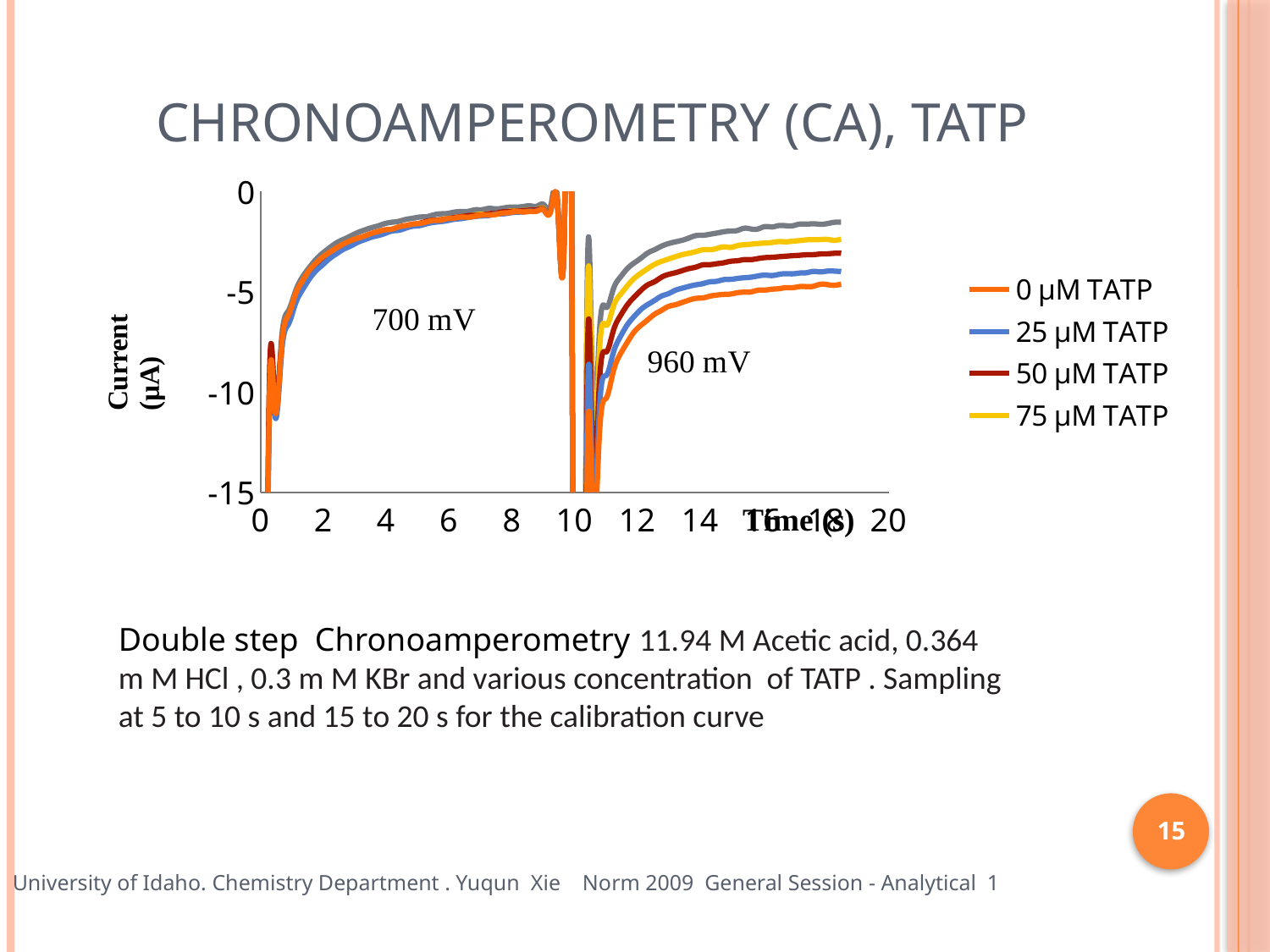
How many tick labels are shown on the x axis? 11 Is the current for 0 µM TATP at 8 s greater or less than -5? greater At 20 s, which series has the higher (less negative) current, 25 µM TATP or 50 µM TATP? 50 µM TATP What is the title of the chart's x axis? Time (s) What is the title of the chart's y axis? Current (µA) How many series does the legend list? 4 Is the current for 75 µM TATP at 20 s greater or less than -5? greater At 20 s, which series has the higher (less negative) current, 0 µM TATP or 75 µM TATP? 75 µM TATP Which legend series has the lowest (most negative) current at 20 s? 0 µM TATP Between 12 s and 20 s, does the current for 0 µM TATP rise or fall? rise Is the current for 25 µM TATP at 20 s greater or less than -10? greater What kind of chart is shown on the slide? line chart